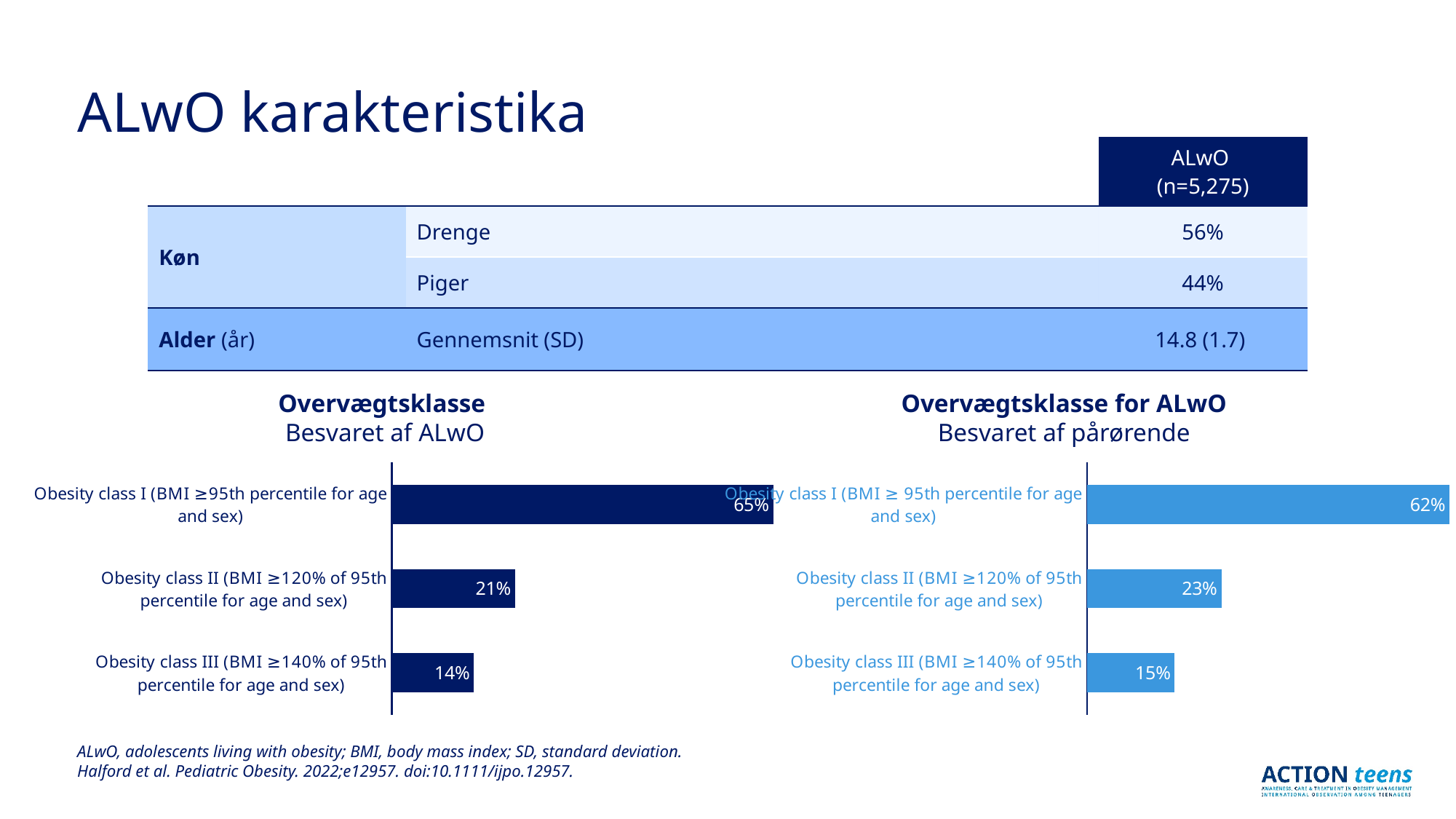
In the left chart (Overvægtsklasse, Besvaret af ALwO), what is the value for Obesity class I? 65% How many obesity classes are shown in the left chart (Overvægtsklasse, Besvaret af ALwO)? 3 Which is larger: Obesity class II in the left chart (Besvaret af ALwO) or Obesity class II in the right chart (Besvaret af pårørende)? Right chart (Besvaret af pårørende), 23% In the right chart (Overvægtsklasse for ALwO, Besvaret af pårørende), what is the difference between Obesity class II and Obesity class III? 8% In the left chart (Overvægtsklasse, Besvaret af ALwO), what is the value for Obesity class III? 14% In the right chart (Overvægtsklasse for ALwO, Besvaret af pårørende), which obesity class has the lowest value? Obesity class III In the left chart (Overvægtsklasse, Besvaret af ALwO), which obesity class has the highest value? Obesity class I What type of chart is the right chart (Overvægtsklasse for ALwO, Besvaret af pårørende)? Bar chart In the left chart (Overvægtsklasse, Besvaret af ALwO), what is the difference between Obesity class I and Obesity class II? 44% In the right chart (Overvægtsklasse for ALwO, Besvaret af pårørende), what is the value for Obesity class II? 23% In the right chart (Overvægtsklasse for ALwO, Besvaret af pårørende), what is the value for Obesity class I? 62% Do the values in the left chart (Overvægtsklasse, Besvaret af ALwO) rise or fall from Obesity class I to Obesity class III? Fall